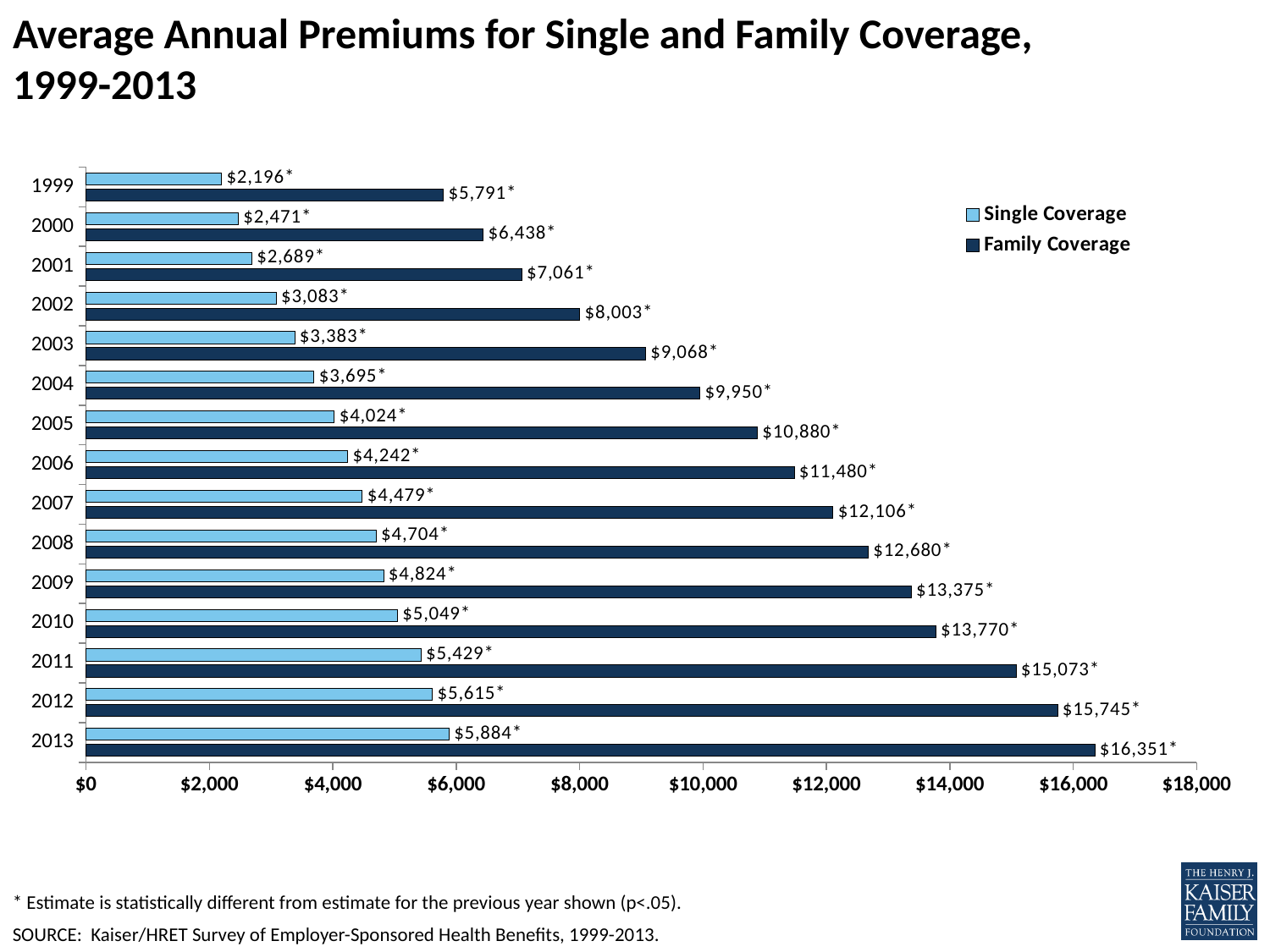
What was the average annual premium for Family Coverage in 2013? $16,351* Do the Single Coverage premiums rise or fall from 1999 to 2013? Rise What kind of chart is shown on the slide? Bar chart Which year has the highest Family Coverage premium? 2013 How many years are shown on the chart? 15 What was the average annual premium for Single Coverage in 1999? $2,196* What is the difference between the Family Coverage and Single Coverage premiums in 2013? $10,467 What was the average annual premium for Single Coverage in 2007? $4,479* How many series does the legend list? 2 Is the Family Coverage premium for 2010 greater or less than $12,000? greater Which is larger, the Family Coverage premium in 2005 or the Family Coverage premium in 2006? 2006 Which year has the lowest Single Coverage premium? 1999